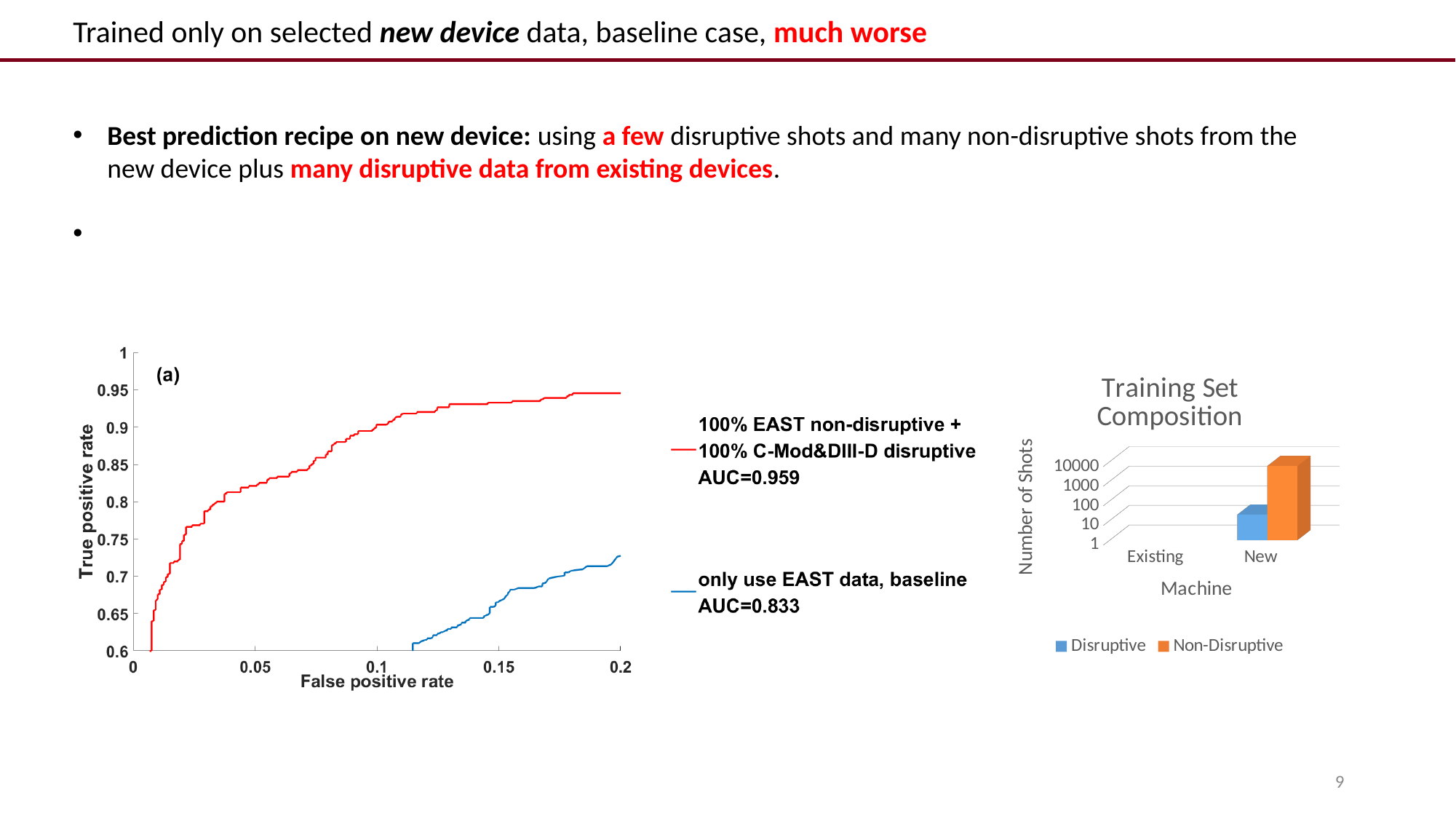
What kind of chart is the 'Training Set Composition' chart? bar chart In the left ROC chart, which curve has the higher AUC? 100% EAST non-disruptive + 100% C-Mod&DIII-D disruptive How many curves are plotted in the left ROC chart? 2 How many machine categories are shown on the x axis of the 'Training Set Composition' chart? 2 In the 'Training Set Composition' chart, is the Non-Disruptive value for New greater or less than 1000? greater What kind of chart is the left chart labelled (a)? line chart In the left ROC chart, what is the difference between the two AUC values shown? 0.126 In the 'Training Set Composition' chart, is the Disruptive value for New greater or less than 100? less In the left ROC chart, what is the AUC of the '100% EAST non-disruptive + 100% C-Mod&DIII-D disruptive' curve? 0.959 How many series does the legend of the 'Training Set Composition' chart list? 2 In the left ROC chart, what is the AUC of the 'only use EAST data, baseline' curve? 0.833 In the 'Training Set Composition' chart, which series has the larger value for New, Disruptive or Non-Disruptive? Non-Disruptive